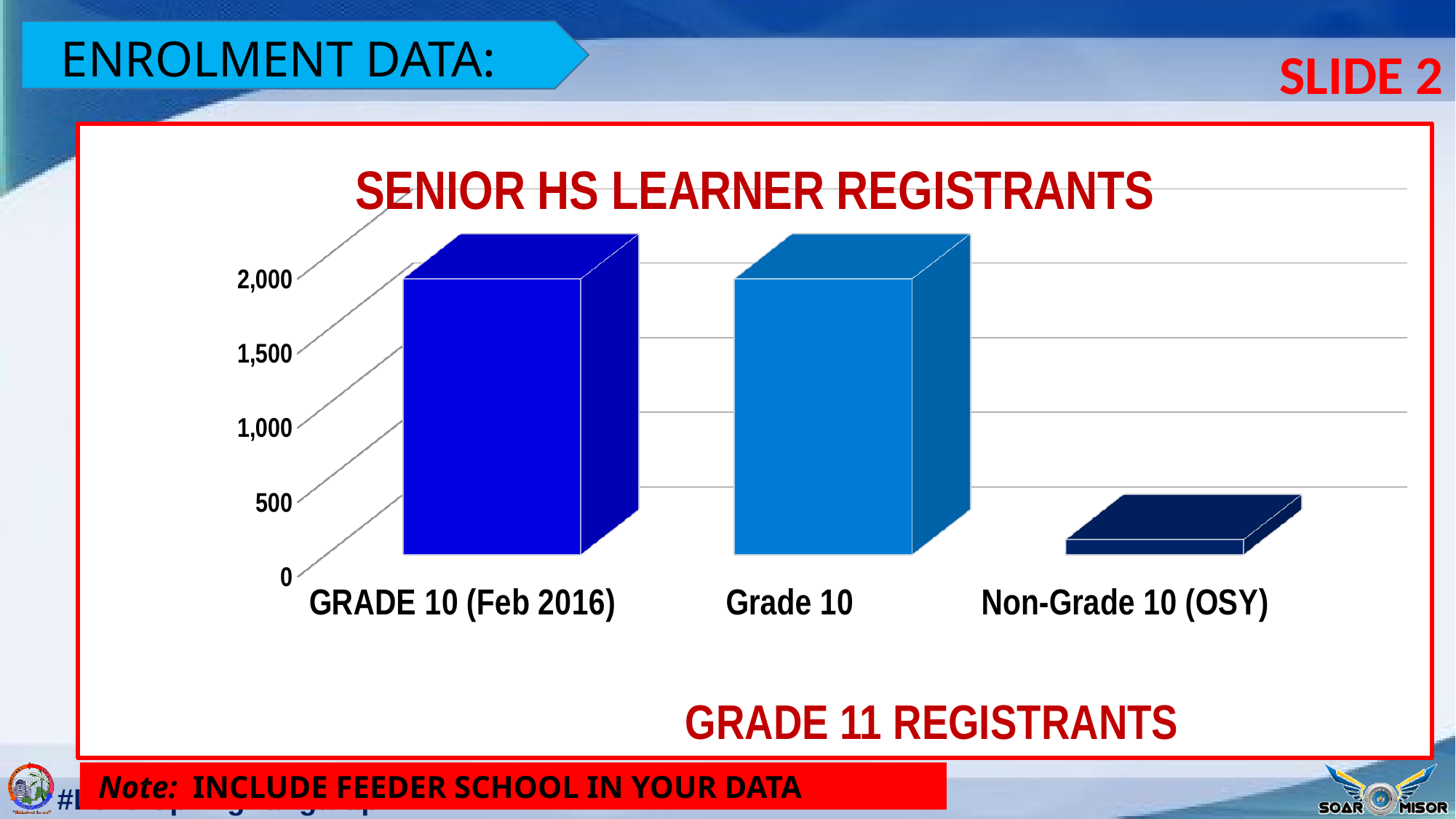
Which is larger, the value for Grade 10 or the value for Non-Grade 10 (OSY)? Grade 10 Is the value for Grade 10 greater or less than 1,000? greater Is the value for GRADE 10 (Feb 2016) greater or less than 1,500? greater How many categories are plotted on the chart? 3 Which category has the lowest value? Non-Grade 10 (OSY) What is the highest value shown on the vertical axis? 2,000 Is the value for Non-Grade 10 (OSY) greater or less than 500? less Which is larger, the value for GRADE 10 (Feb 2016) or the value for Non-Grade 10 (OSY)? GRADE 10 (Feb 2016) What kind of chart is shown on the slide? bar chart What is the title of the chart? SENIOR HS LEARNER REGISTRANTS